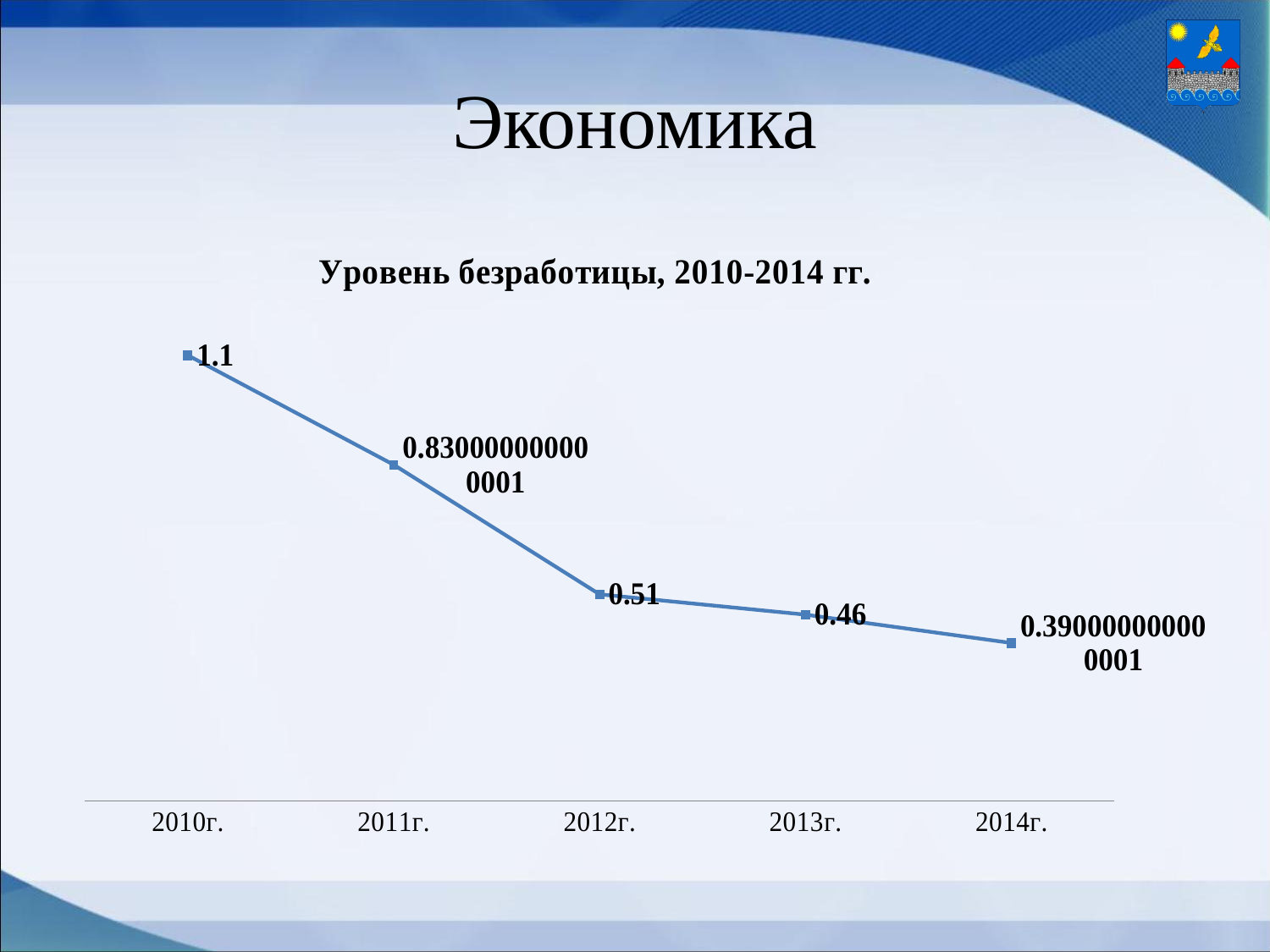
What is the difference between the values for 2010г. and 2012г.? 0.59 Which year has the lowest value? 2014г. What is the value for 2013г.? 0.46 What is the data label shown for 2011г.? 0.830000000000001 What is the value for 2012г.? 0.51 What is the value for 2010г.? 1.1 How many years are plotted on the chart? 5 Which is larger, the value for 2012г. or the value for 2013г.? 2012г. What is the data label shown for 2014г.? 0.390000000000001 What kind of chart is shown on the slide? line chart Which year has the highest value? 2010г. What is the title of the chart? Уровень безработицы, 2010-2014 гг.